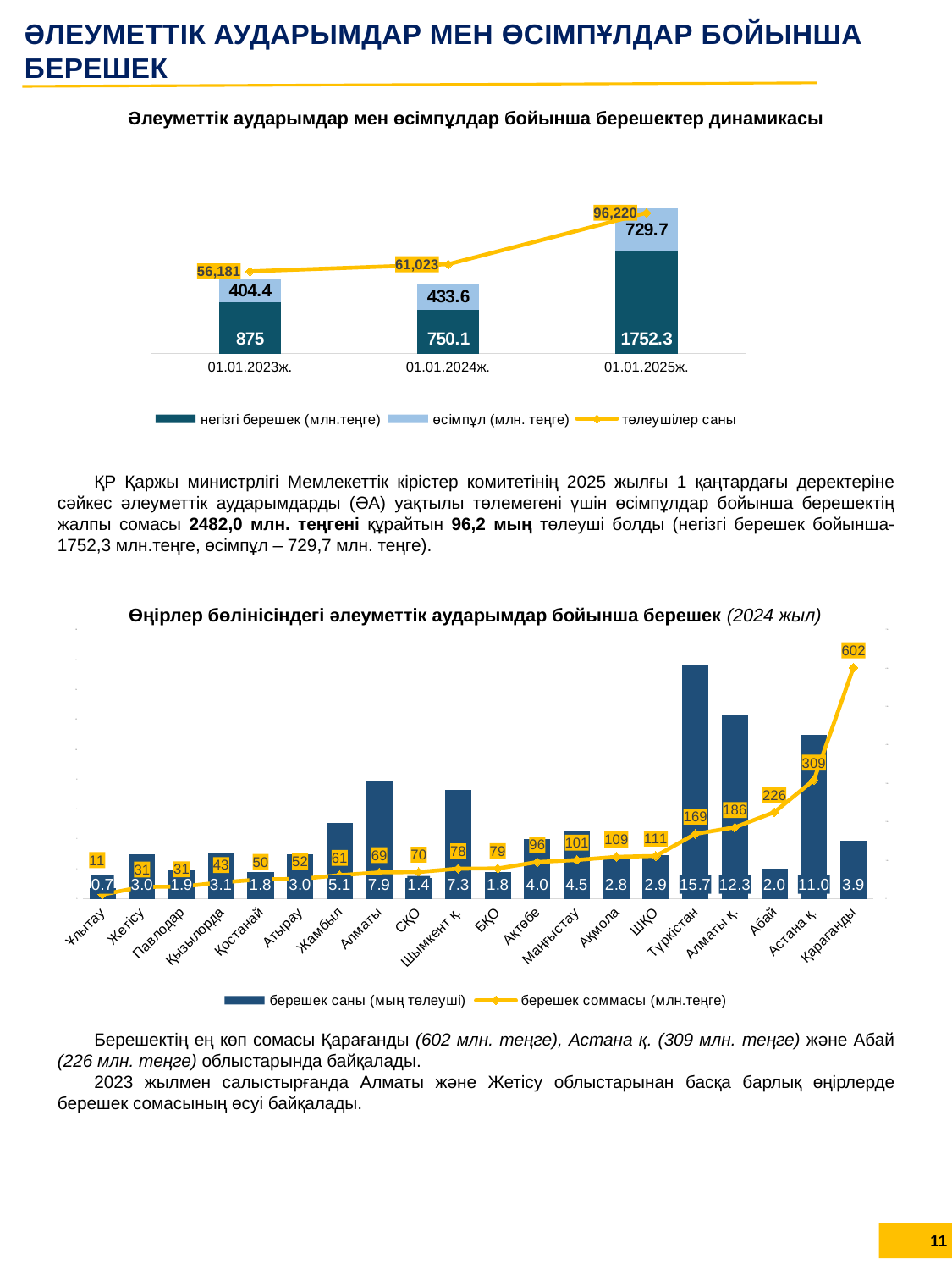
In the bottom chart (Өңірлер бөлінісіндегі берешек), what is the difference in берешек соммасы (млн.теңге) between Астана қ. and Абай? 83 In the bottom chart (Өңірлер бөлінісіндегі берешек), what is the берешек саны (мың төлеуші) for Түркістан? 15.7 In the top chart (берешектер динамикасы), what is the value of өсімпұл for 01.01.2024ж.? 433.6 In the bottom chart (Өңірлер бөлінісіндегі берешек), how many regions are shown on the x axis? 20 In the top chart (берешектер динамикасы), does the төлеушілер саны line rise or fall from 01.01.2023ж. to 01.01.2025ж.? rise In the bottom chart (Өңірлер бөлінісіндегі берешек), which region has the lowest берешек саны (мың төлеуші)? Ұлытау In the top chart (берешектер динамикасы), how many series does the legend list? 3 In the bottom chart (Өңірлер бөлінісіндегі берешек), which region has the highest берешек соммасы (млн.теңге)? Қарағанды In the top chart (берешектер динамикасы), what is the value of негізгі берешек for 01.01.2025ж.? 1752.3 In the top chart (берешектер динамикасы), what is the төлеушілер саны for 01.01.2023ж.? 56,181 In the top chart (берешектер динамикасы), what is the total of the stacked bar for 01.01.2025ж. (негізгі берешек plus өсімпұл)? 2482.0 In the bottom chart (Өңірлер бөлінісіндегі берешек), which has the larger берешек саны (мың төлеуші): Алматы қ. or Астана қ.? Алматы қ.